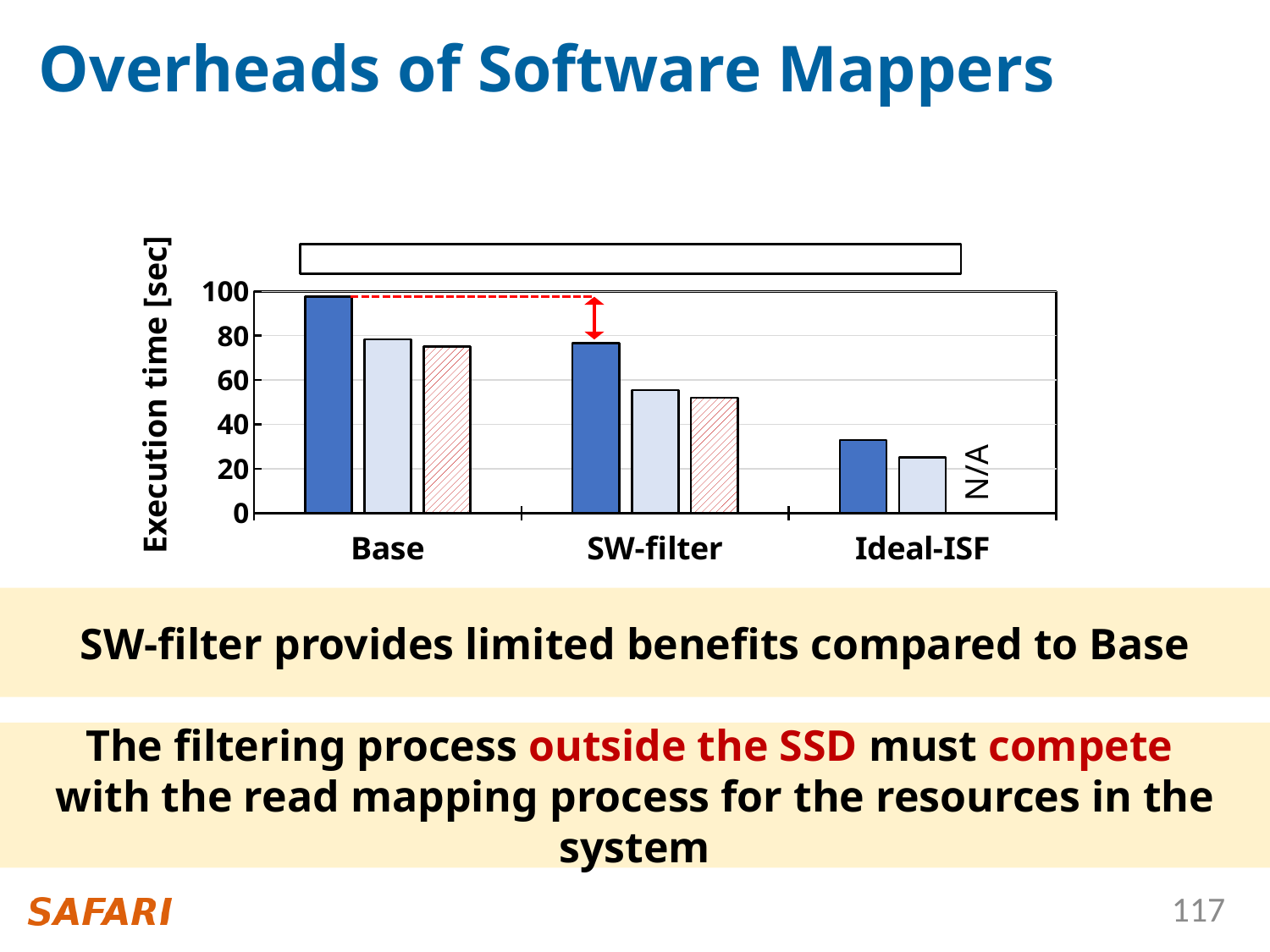
Which category has the shortest dark blue bar? Ideal-ISF For which category is the third (red hatched) bar marked N/A? Ideal-ISF What is the label of the y axis of the chart? Execution time [sec] Is the dark blue bar for Ideal-ISF greater or less than 40? less What kind of chart is shown on the slide? bar chart Which category has the tallest dark blue bar? Base Is the light blue bar for Ideal-ISF greater or less than 40? less Is the dark blue bar for Base greater or less than 80? greater Do the dark blue bars rise or fall from Base to Ideal-ISF along the x axis? fall How many categories are shown on the x axis of the chart? 3 Which has the larger dark blue bar, Base or SW-filter? Base